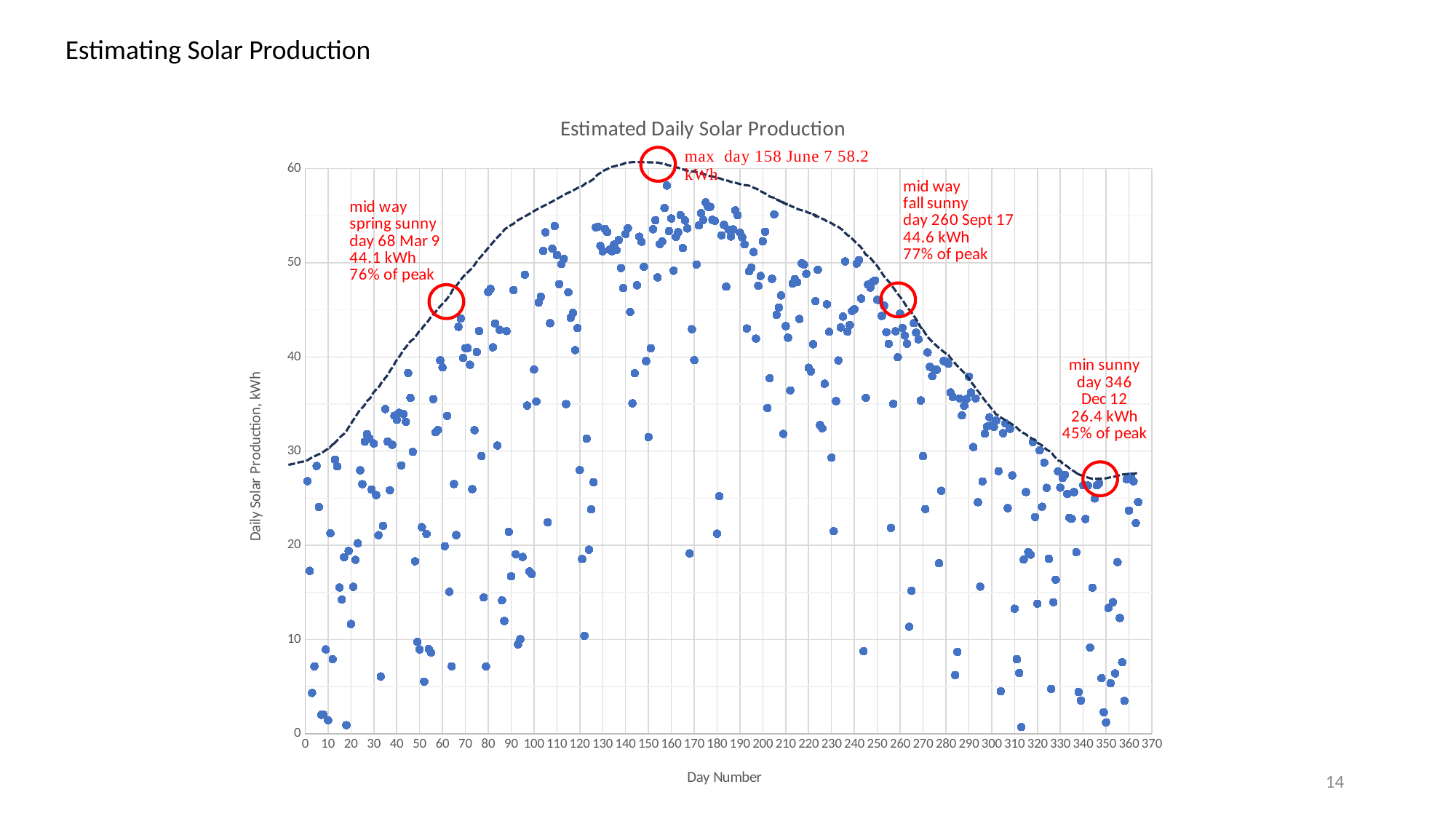
What is the annotated production value for the mid-way spring sunny day (day 68)? 44.1 kWh What percentage of peak is the annotated value for day 346 (Dec 12)? 45% of peak What kind of chart is shown on the slide? Scatter chart On which day number does the annotated maximum of the dashed curve occur? Day 158 What is the annotated production value for the mid-way fall sunny day (day 260)? 44.6 kWh Is the annotated value for day 346 (Dec 12) greater or less than 30 kWh? less Which annotated value is larger: the mid-way spring sunny day (day 68) or the mid-way fall sunny day (day 260)? Mid-way fall sunny day (day 260) What is the difference between the annotated maximum (day 158) and the annotated minimum sunny value (day 346)? 31.8 kWh What is the annotated production value for the minimum sunny day (day 346)? 26.4 kWh According to the annotation, what is the maximum estimated daily solar production on the dashed curve? 58.2 kWh What is the label of the vertical axis? Daily Solar Production, kWh What is the title of the chart? Estimated Daily Solar Production